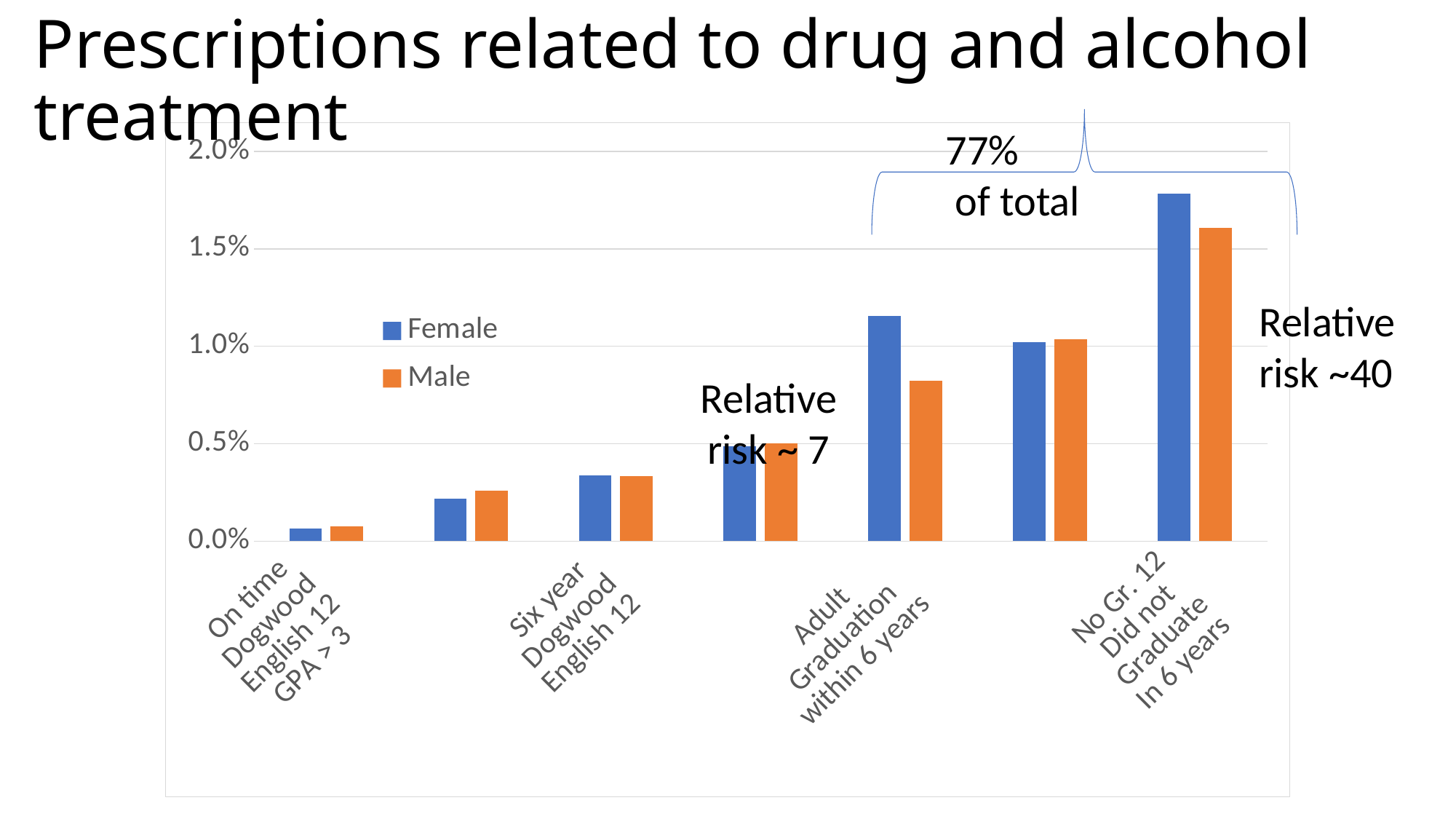
Is the Female value for 'No Gr. 12 Did not Graduate In 6 years' greater or less than 1.5%? greater Is the Female value for 'Six year Dogwood English 12' greater or less than 0.5%? less What relative risk is annotated next to the 'No Gr. 12 Did not Graduate In 6 years' bars? Relative risk ~40 Which two series are listed in the legend? Female and Male Which labelled category has the lowest Male value? On time Dogwood English 12 GPA > 3 Which category has the highest Female value? No Gr. 12 Did not Graduate In 6 years How many category groups of bars are plotted on the chart? 7 Is the Male value for 'Adult Graduation within 6 years' greater or less than 1.0%? less Do the values generally rise or fall moving from left to right across the categories? rise How many series does the legend list? 2 For 'Adult Graduation within 6 years', which is larger, the Female or the Male value? Female What kind of chart is shown on the slide? bar chart